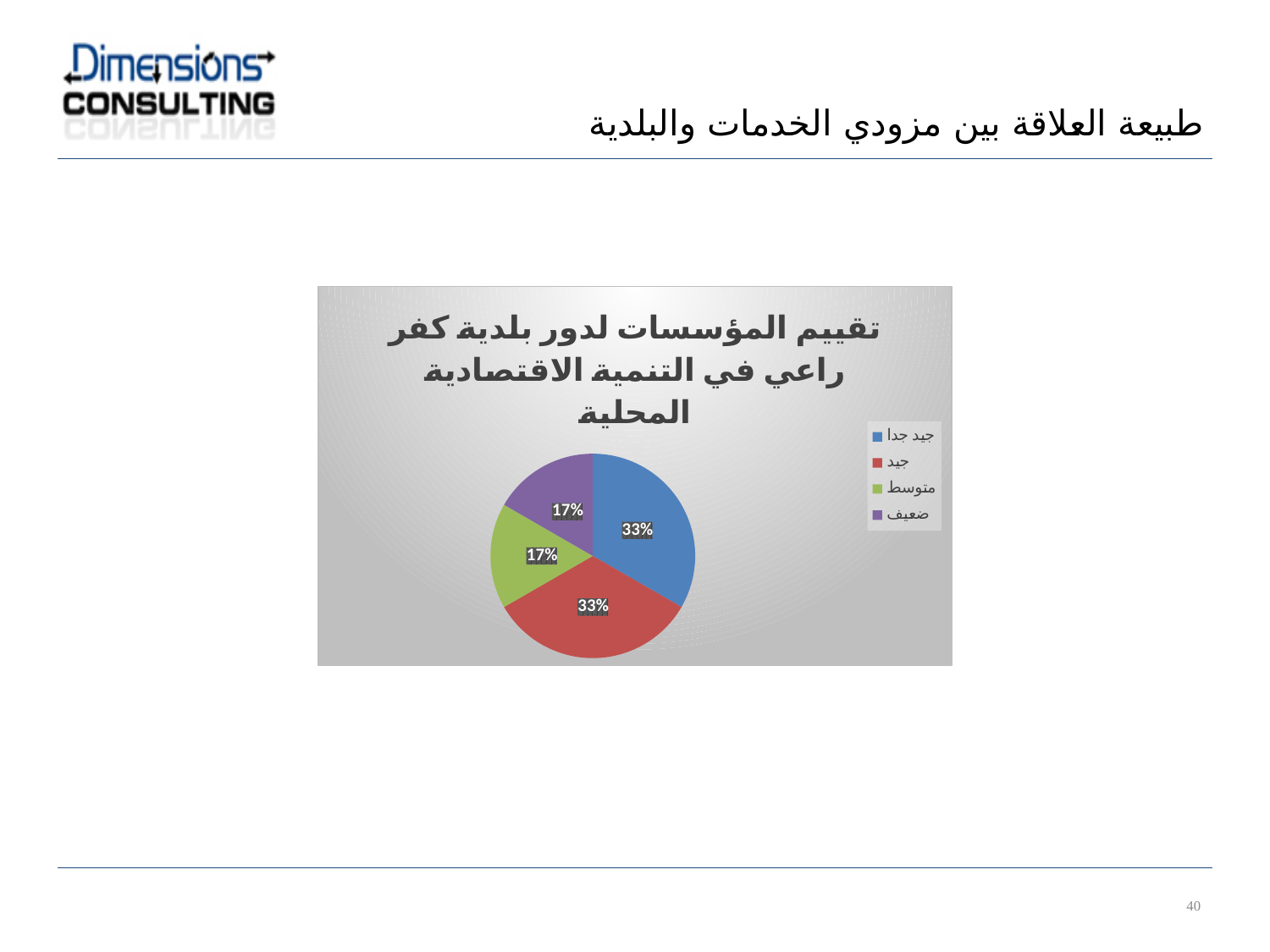
What is the title of the pie chart? تقييم المؤسسات لدور بلدية كفر راعي في التنمية الاقتصادية المحلية What is the difference in percentage points between the جيد slice and the ضعيف slice? 16 How many entries does the legend list? 4 What colour is the جيد جدا slice in the pie chart? blue What type of chart is shown on the slide? pie chart What percentage of the pie is the متوسط slice? 17% Which slice is larger, ضعيف or جيد? جيد How many slices does the pie chart have? 4 What percentage of the pie is the جيد جدا slice? 33% What percentage of the pie is the جيد slice? 33% What percentage of the pie is the ضعيف slice? 17% Which slice is larger, جيد جدا or متوسط? جيد جدا